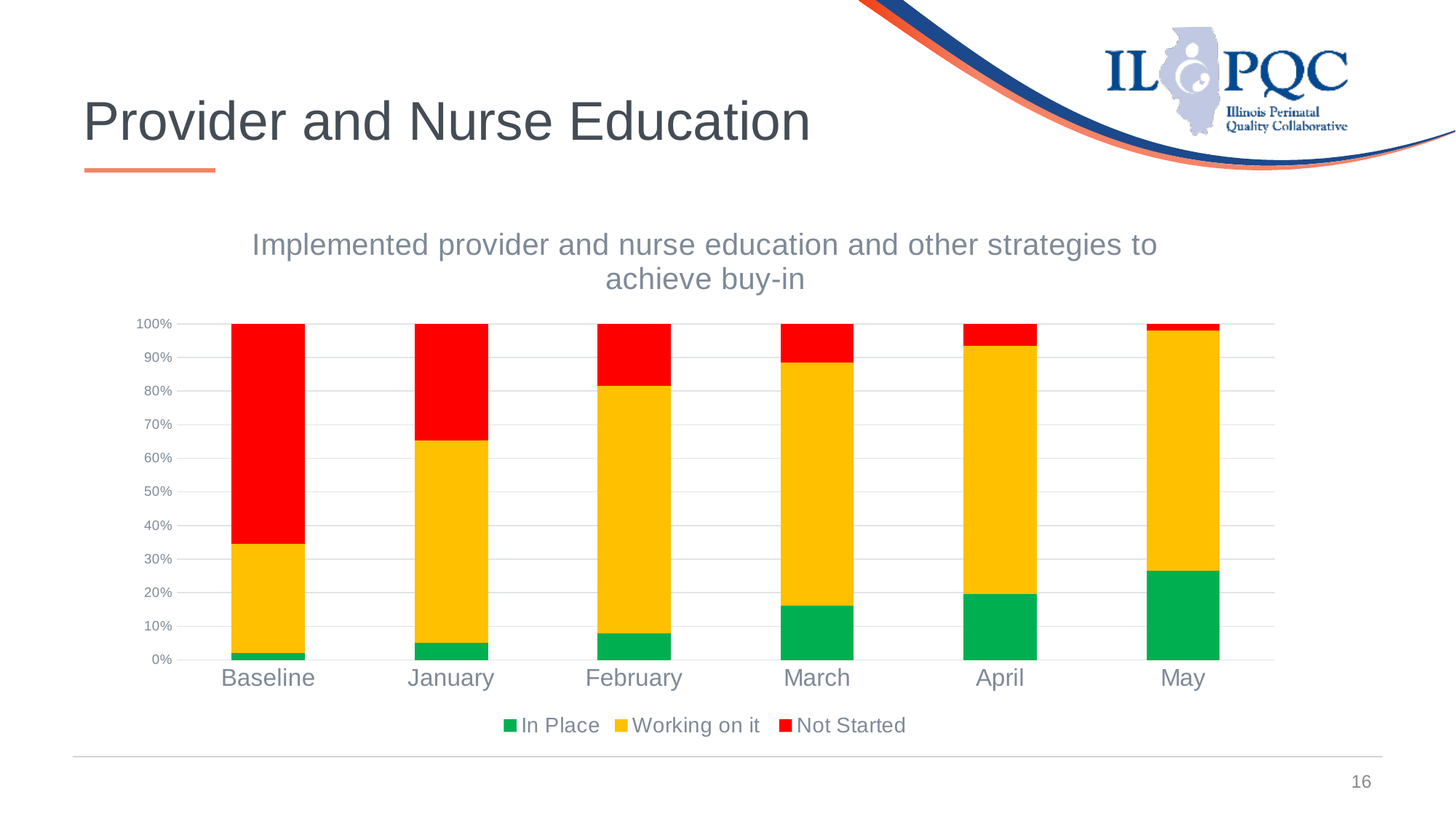
Does the In Place share rise or fall from Baseline to May? Rises Which category has the smallest In Place segment? Baseline What kind of chart is shown on the slide? Stacked bar chart How many series does the chart's legend list? 3 Which category has the largest In Place segment? May Which category has the largest Not Started segment? Baseline Which series is shown in red in the chart? Not Started Is the In Place value for May greater or less than 20%? greater What is the title of the chart? Implemented provider and nurse education and other strategies to achieve buy-in How many categories are shown along the x axis of the chart? 6 Which is larger, the Not Started segment for January or for April? January Is the Not Started value for Baseline greater or less than 60%? greater